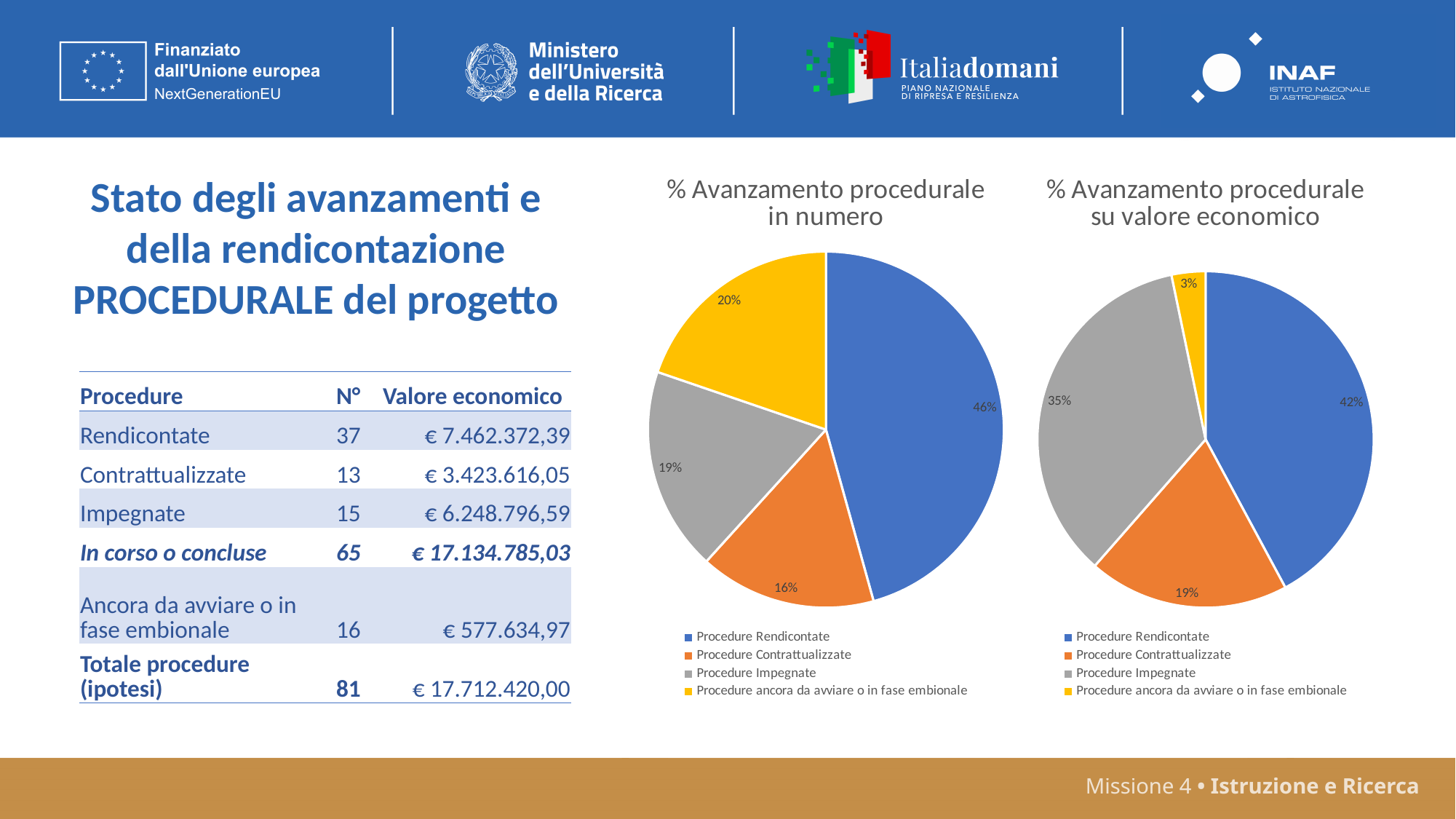
In the chart titled '% Avanzamento procedurale in numero', which category has the smallest slice? Procedure Contrattualizzate In the chart titled '% Avanzamento procedurale in numero', what is the difference in percentage points between Procedure Rendicontate and Procedure Impegnate? 27 percentage points How many categories does the legend of the chart titled '% Avanzamento procedurale in numero' list? 4 In the chart titled '% Avanzamento procedurale su valore economico', what share is shown for Procedure ancora da avviare o in fase embionale? 3% In the chart titled '% Avanzamento procedurale in numero', what share is shown for Procedure ancora da avviare o in fase embionale? 20% What type of chart is '% Avanzamento procedurale su valore economico'? Pie chart In the chart titled '% Avanzamento procedurale su valore economico', which category has the largest slice? Procedure Rendicontate In the chart titled '% Avanzamento procedurale in numero', what share is shown for Procedure Contrattualizzate? 16% In the chart titled '% Avanzamento procedurale su valore economico', which category has the smallest slice? Procedure ancora da avviare o in fase embionale In the chart titled '% Avanzamento procedurale su valore economico', which is larger: Procedure Impegnate or Procedure Contrattualizzate? Procedure Impegnate